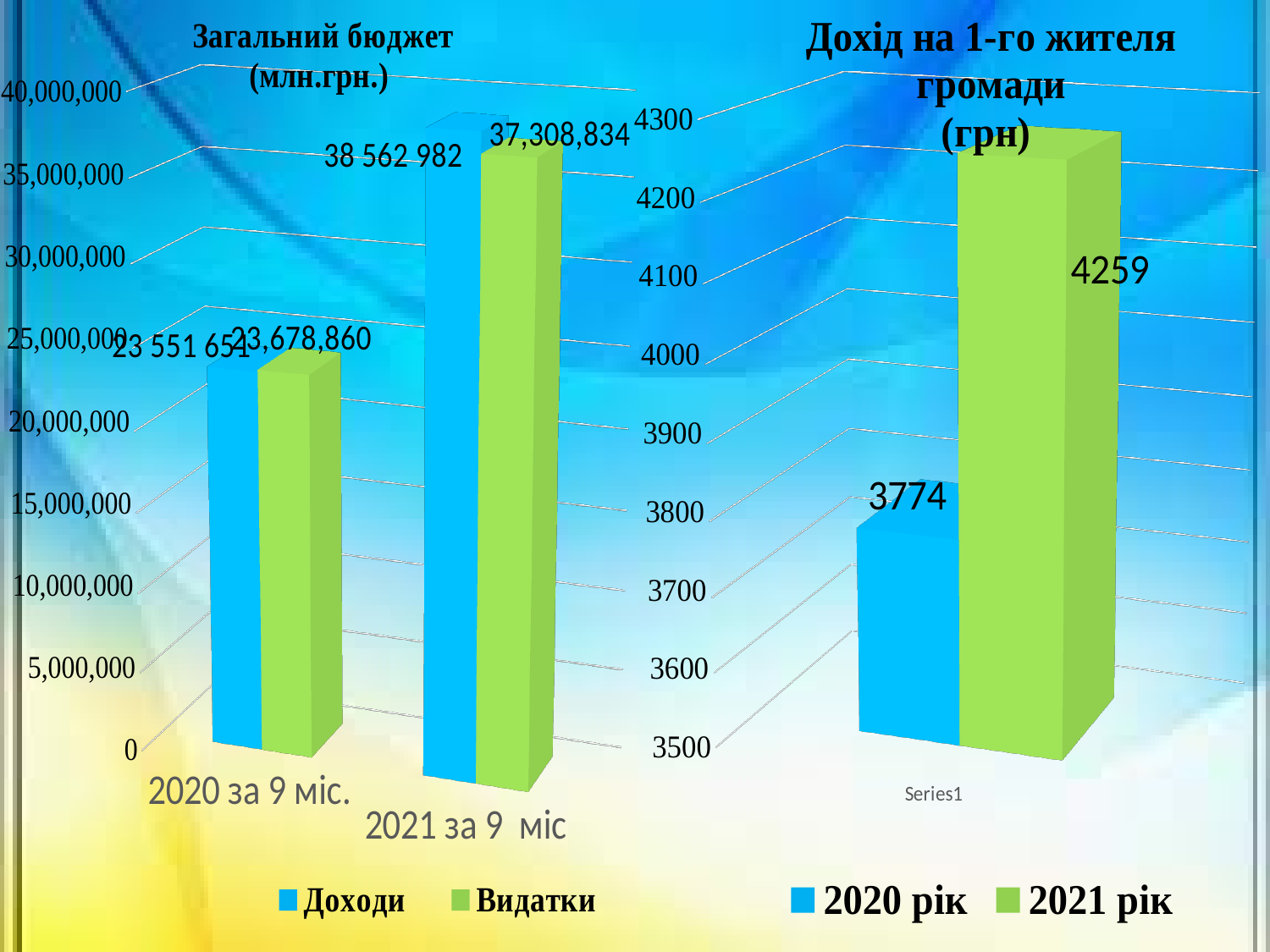
In the chart 'Загальний бюджет (млн.грн.)', what is the difference between Доходи and Видатки for '2021 за 9 міс'? 1 254 148 In the chart 'Загальний бюджет (млн.грн.)', what is the value of Доходи for '2021 за 9 міс'? 38 562 982 What kind of chart is 'Дохід на 1-го жителя громади (грн)'? bar chart In the chart 'Загальний бюджет (млн.грн.)', do the Доходи values rise or fall from 2020 to 2021? rise In the chart 'Дохід на 1-го жителя громади (грн)', which series has the higher value? 2021 рік In the chart 'Дохід на 1-го жителя громади (грн)', what is the value for 2021 рік? 4259 In the chart 'Загальний бюджет (млн.грн.)', what is the value of Видатки for '2021 за 9 міс'? 37,308,834 In the chart 'Дохід на 1-го жителя громади (грн)', what is the difference between 2021 рік and 2020 рік? 485 In the chart 'Загальний бюджет (млн.грн.)', how many series does the legend list? 2 In the chart 'Загальний бюджет (млн.грн.)', what is the value of Видатки for '2020 за 9 міс.'? 23,678,860 In the chart 'Дохід на 1-го жителя громади (грн)', what is the value for 2020 рік? 3774 In the chart 'Загальний бюджет (млн.грн.)', which is larger for '2021 за 9 міс': Доходи or Видатки? Доходи